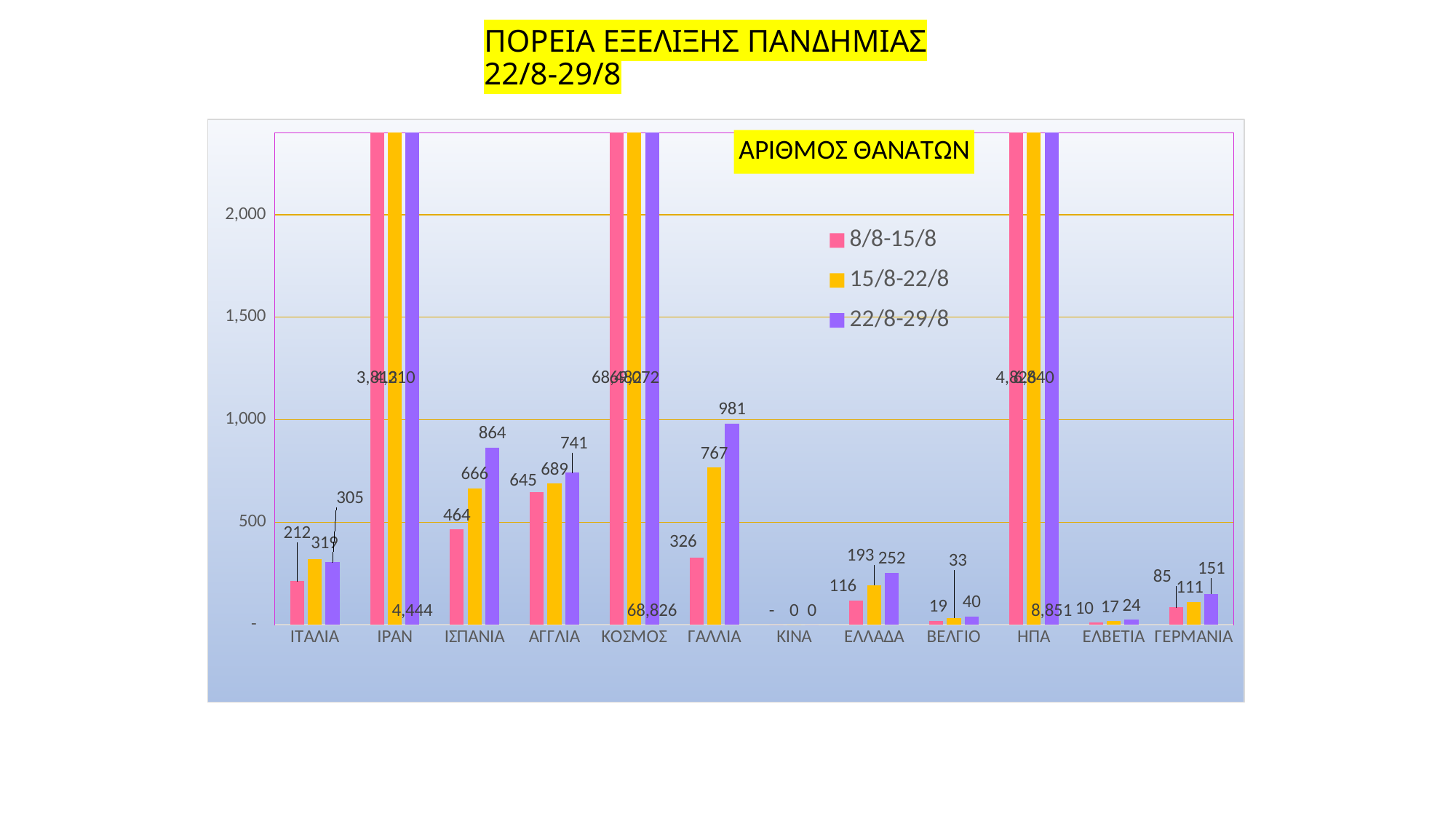
What is the value for ΓΑΛΛΙΑ in the 15/8-22/8 series? 767 What is the difference between the 22/8-29/8 and 8/8-15/8 values for ΓΕΡΜΑΝΙΑ? 66 What is the value for ΕΛΛΑΔΑ in the 8/8-15/8 series? 116 Which category has the lowest values across all three series? ΚΙΝΑ What is the value for ΗΠΑ in the 22/8-29/8 series? 8,851 How many series does the legend list? 3 Which is larger for ΑΓΓΛΙΑ: the 15/8-22/8 value or the 22/8-29/8 value? 22/8-29/8 What type of chart is shown on the slide? bar chart Do the values for ΕΛΛΑΔΑ rise or fall across the three periods from 8/8-15/8 to 22/8-29/8? rise What is the title shown inside the chart area? ΑΡΙΘΜΟΣ ΘΑΝΑΤΩΝ What is the value for ΙΣΠΑΝΙΑ in the 22/8-29/8 series? 864 How many countries/categories are shown on the x axis? 12